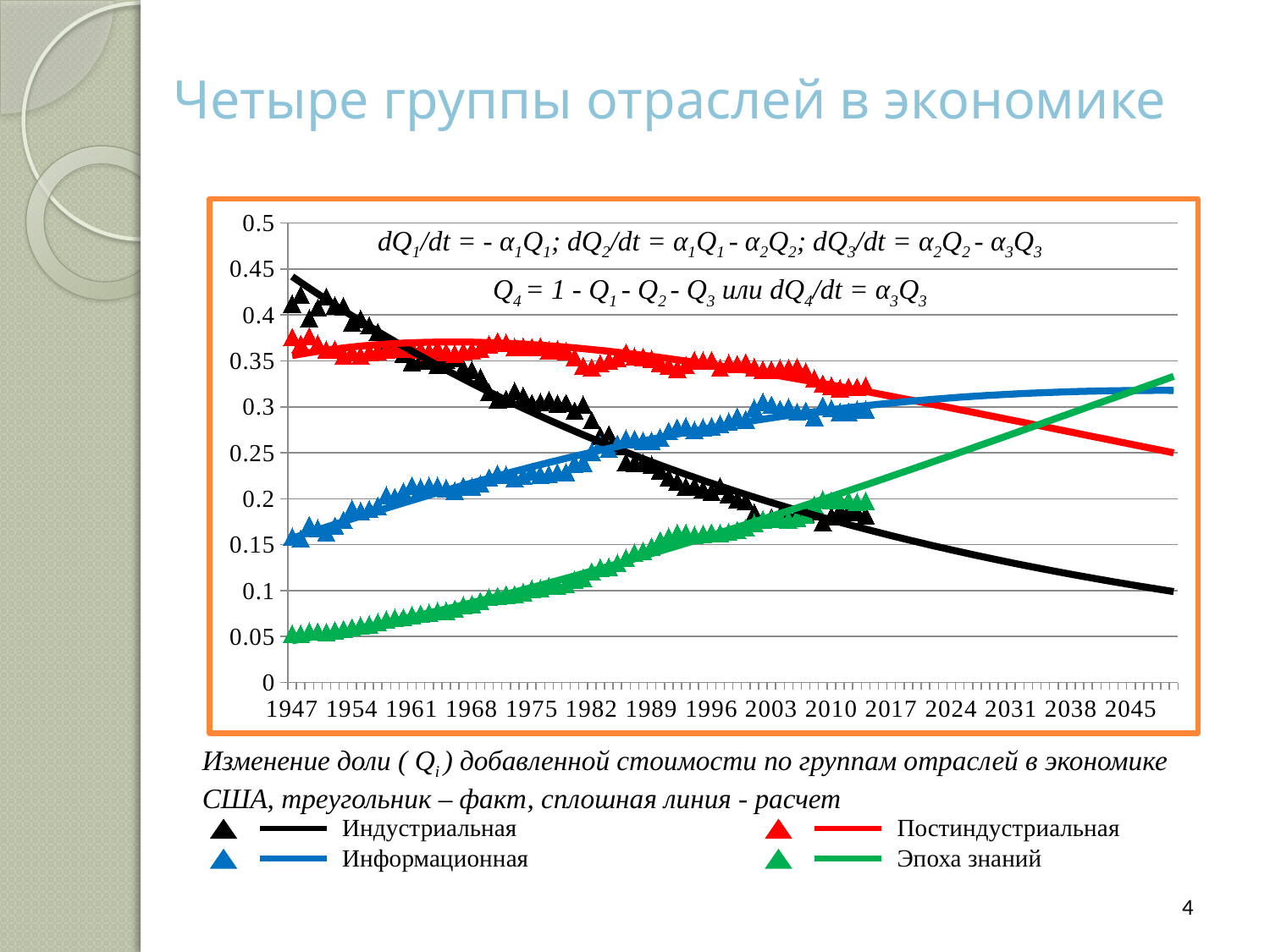
Does the Индустриальная series rise or fall along the x axis? fall Which series has the lowest value in 1947? Эпоха знаний Does the Эпоха знаний series rise or fall along the x axis? rise What kind of chart is shown on the slide? line chart Is the value for Эпоха знаний in 1947 greater or less than 0.1? less What is the title of the slide? Четыре группы отраслей в экономике How many series does the legend list? 4 Which series has the lowest value at the right end of the chart (around 2045)? Индустриальная Which series has the highest value in 1947? Индустриальная Is the value for Индустриальная in 1947 greater or less than 0.4? greater In 1947, which is larger: the value for Индустриальная or the value for Информационная? Индустриальная Which colour is used for the series Эпоха знаний? green